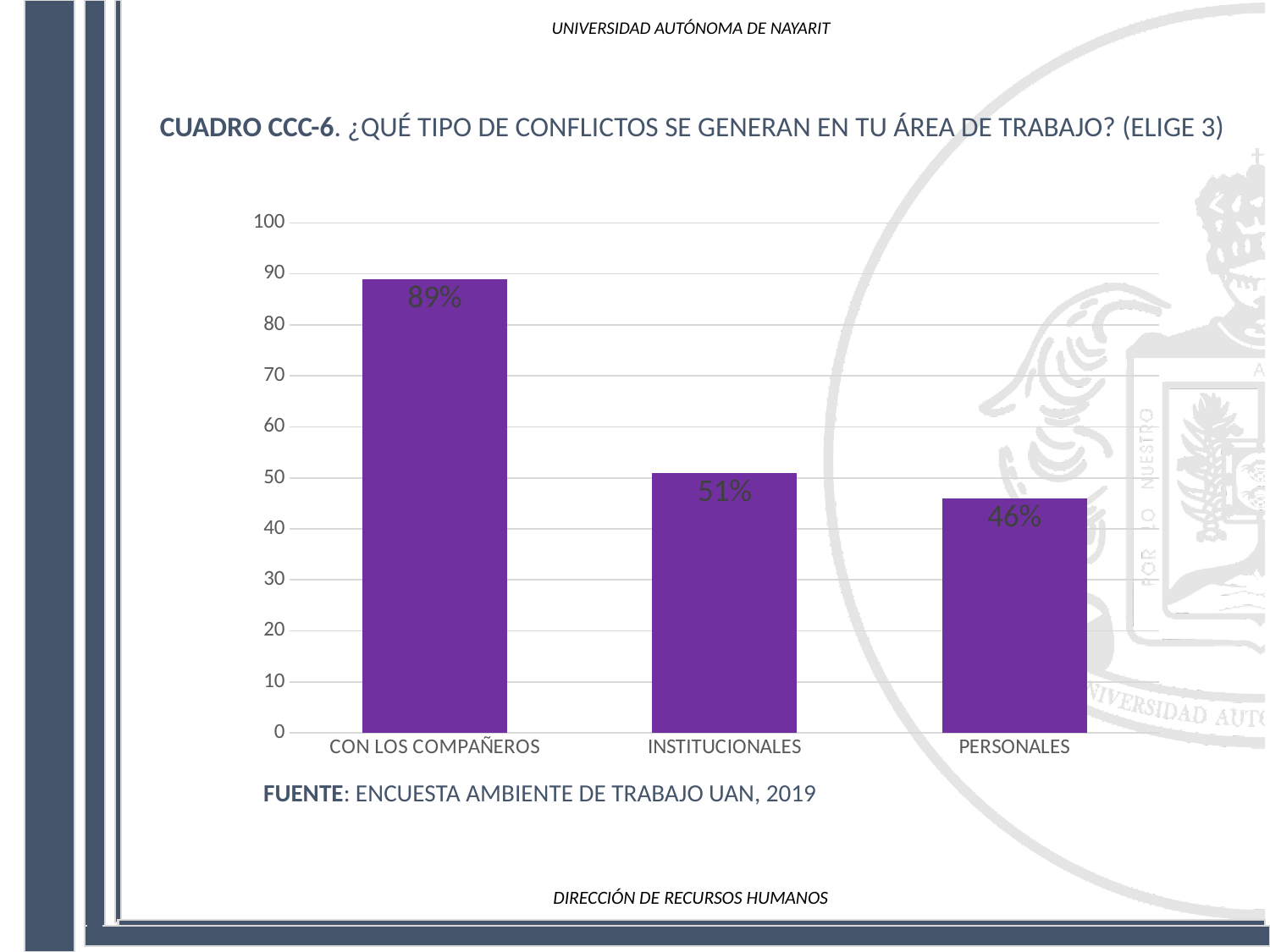
Which category has the highest value? CON LOS COMPAÑEROS What is the difference between the values for INSTITUCIONALES and PERSONALES? 5% What kind of chart is shown on the slide? bar chart What is the value for INSTITUCIONALES? 51% Which is larger, the value for INSTITUCIONALES or the value for PERSONALES? INSTITUCIONALES What is the value for CON LOS COMPAÑEROS? 89% What is the difference between the values for CON LOS COMPAÑEROS and INSTITUCIONALES? 38% What source is cited below the chart? ENCUESTA AMBIENTE DE TRABAJO UAN, 2019 How many categories are shown in the chart? 3 Which category has the lowest value? PERSONALES What is the value for PERSONALES? 46% Is the value for PERSONALES greater or less than 50? less